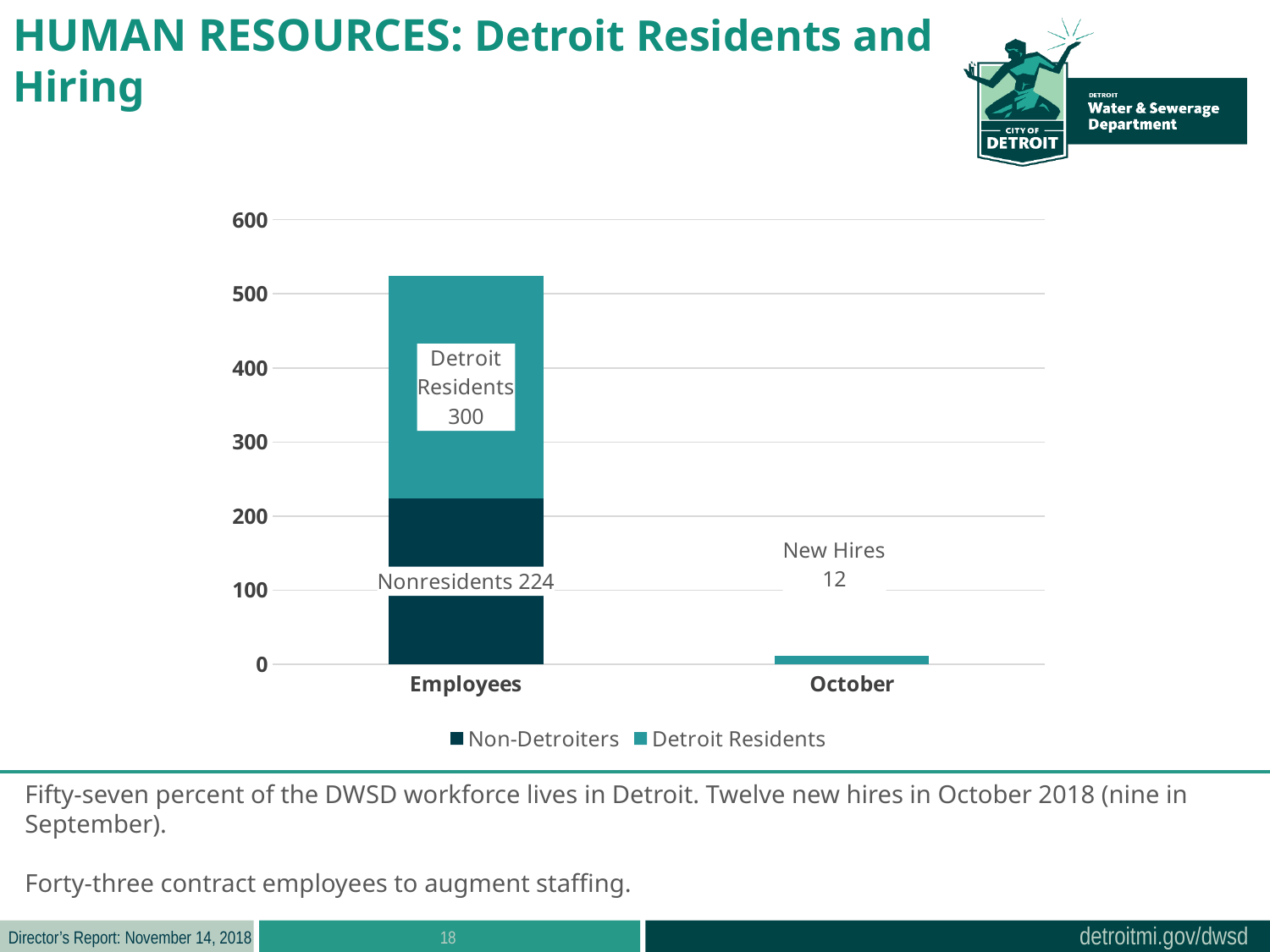
What is the difference between Detroit Residents (300) and Nonresidents (224) in the Employees bar? 76 What kind of chart is shown on the slide? stacked bar chart What is the total of the stacked Employees bar? 524 How many categories are shown on the x axis? 2 How many series does the legend list? 2 What is the value for Nonresidents in the Employees bar? 224 What are the two series names in the legend? Non-Detroiters and Detroit Residents In the Employees bar, which is larger: Detroit Residents or Nonresidents? Detroit Residents What is the value for Detroit Residents in the Employees bar? 300 Is the value for October greater or less than 100? less What is the value labelled New Hires for October? 12 Is the total of the Employees bar greater or less than 500? greater